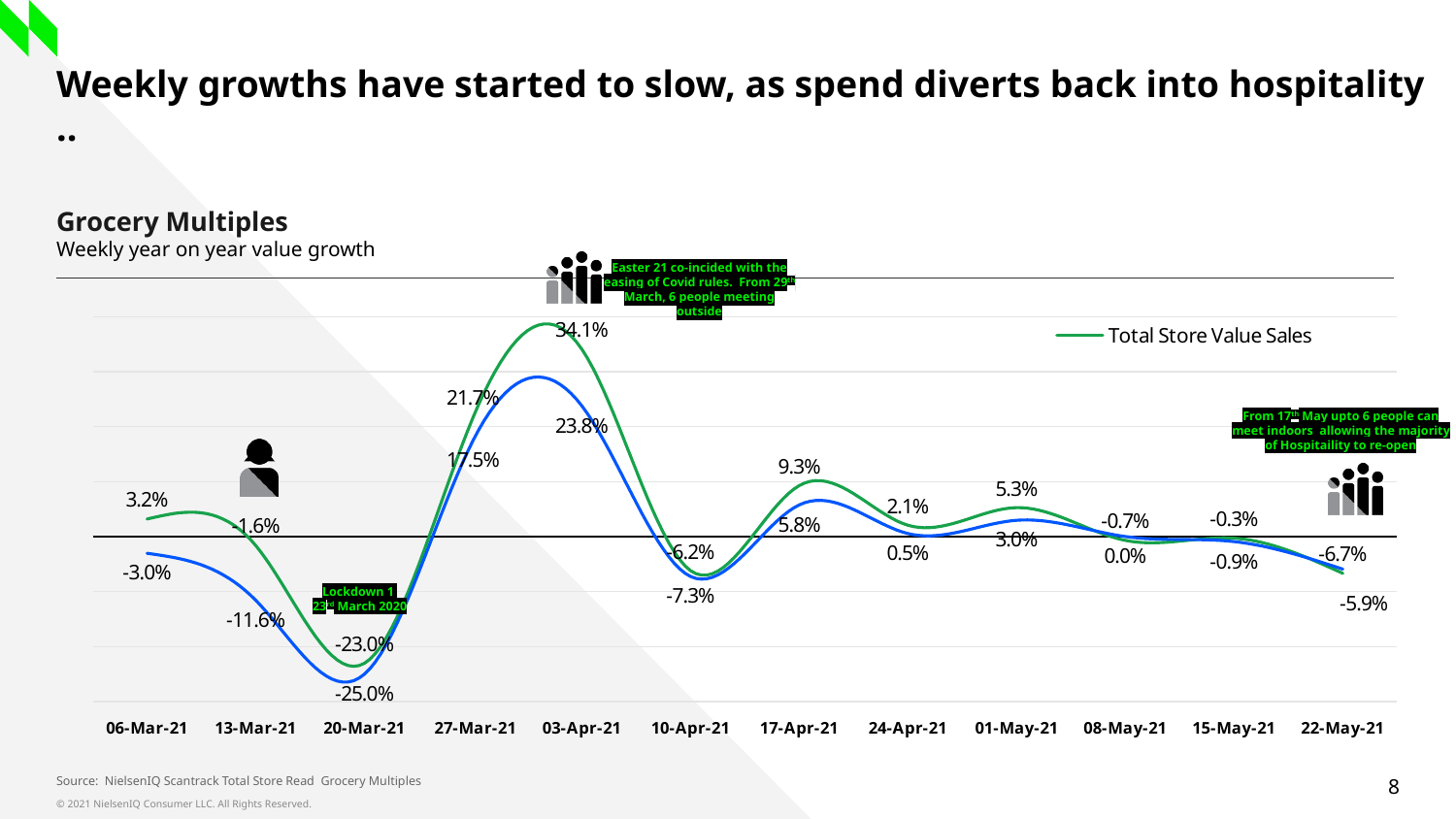
What is the title of the chart? Grocery Multiples What is the lowest value labelled on the chart? -25.0% How many weekly dates are shown on the x axis? 12 Does the Total Store Value Sales line rise or fall between 03-Apr-21 and 10-Apr-21? fall On which date does the chart reach its lowest labelled value? 20-Mar-21 What series name is shown in the chart legend? Total Store Value Sales On which date does the chart reach its highest labelled value? 03-Apr-21 What type of chart is shown on the slide? line chart What is the Total Store Value Sales growth for 03-Apr-21? 34.1% How many series does the chart legend list? 1 What is the difference between the highest labelled value (34.1%) and the lowest labelled value (-25.0%)? 59.1 percentage points What is the highest value labelled on the chart? 34.1%